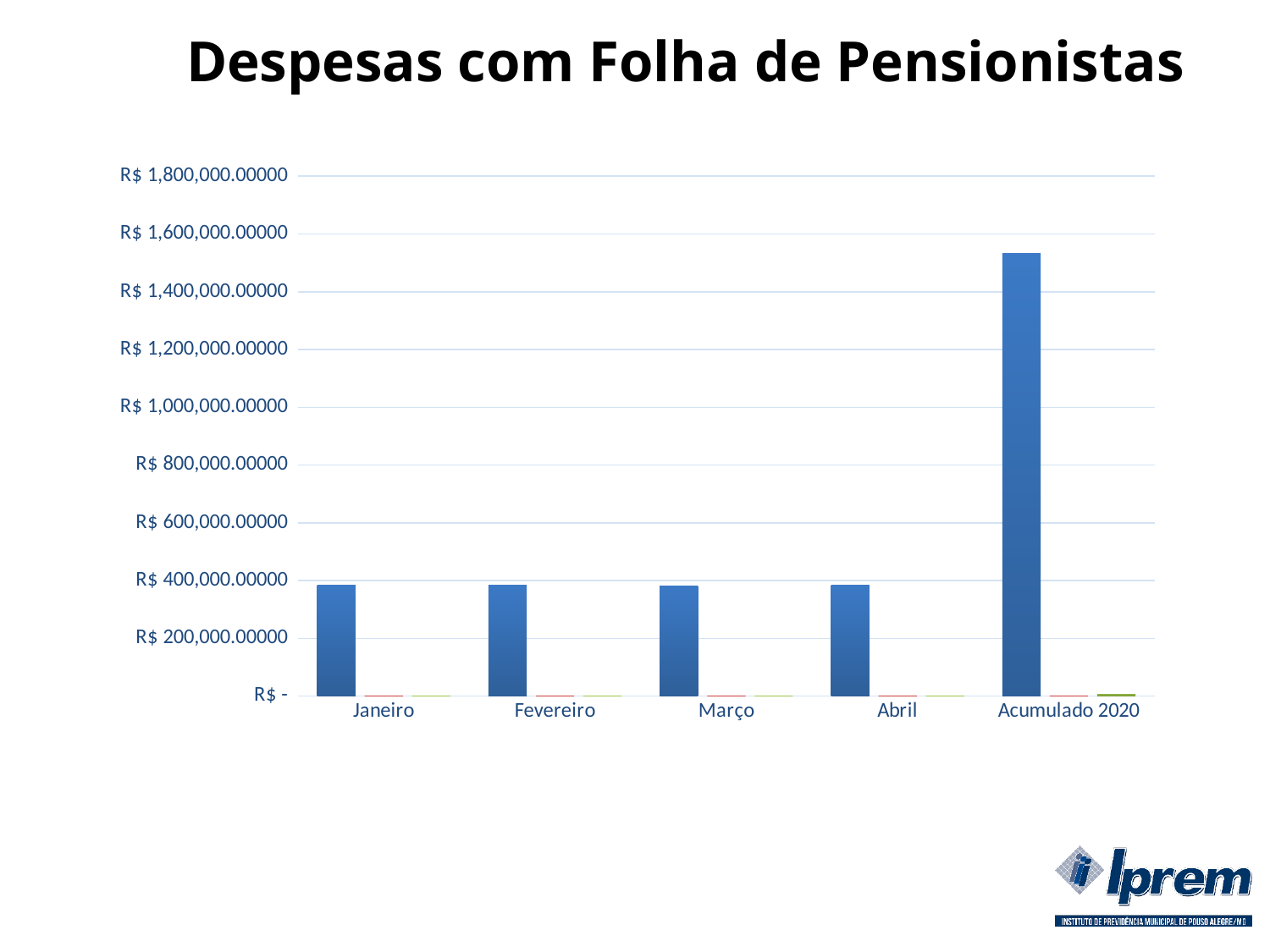
How many categories are shown on the x axis of the chart? 5 Which is larger, the blue bar for Acumulado 2020 or the blue bar for Fevereiro? Acumulado 2020 What kind of chart is shown on the slide? bar chart Is the blue bar for Abril greater or less than R$ 600,000.00000? less What is the label of the last category on the x axis? Acumulado 2020 What is the title of the chart? Despesas com Folha de Pensionistas What is the highest value labelled on the vertical axis of the chart? R$ 1,800,000.00000 Is the blue bar for Acumulado 2020 greater or less than R$ 1,400,000.00000? greater Which category has the highest blue bar? Acumulado 2020 Is the blue bar for Março greater or less than R$ 200,000.00000? greater